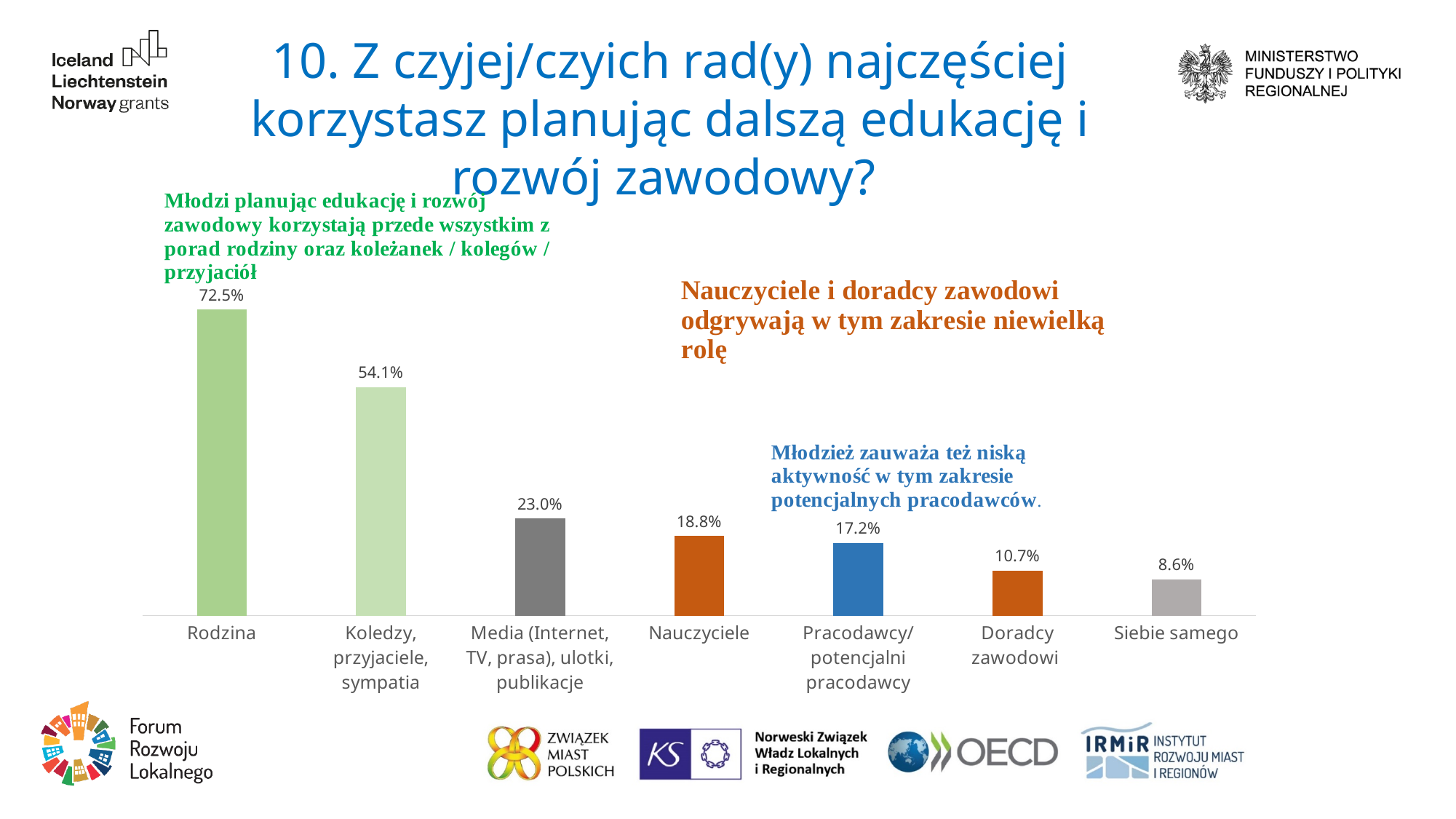
Which category has the highest value? Rodzina Which category has the lowest value? Siebie samego Which is larger, the value for Nauczyciele or the value for Pracodawcy/ potencjalni pracodawcy? Nauczyciele What is the value for Siebie samego? 8.6% What is the difference between the values for Media (Internet, TV, prasa), ulotki, publikacje and Doradcy zawodowi? 12.3% What is the value for Doradcy zawodowi? 10.7% What kind of chart is shown on the slide? Bar chart What is the value for Nauczyciele? 18.8% How many categories are shown in the chart? 7 What is the value for Rodzina? 72.5% Do the values rise or fall from left to right along the x axis? Fall What is the difference between the values for Rodzina and Koledzy, przyjaciele, sympatia? 18.4%